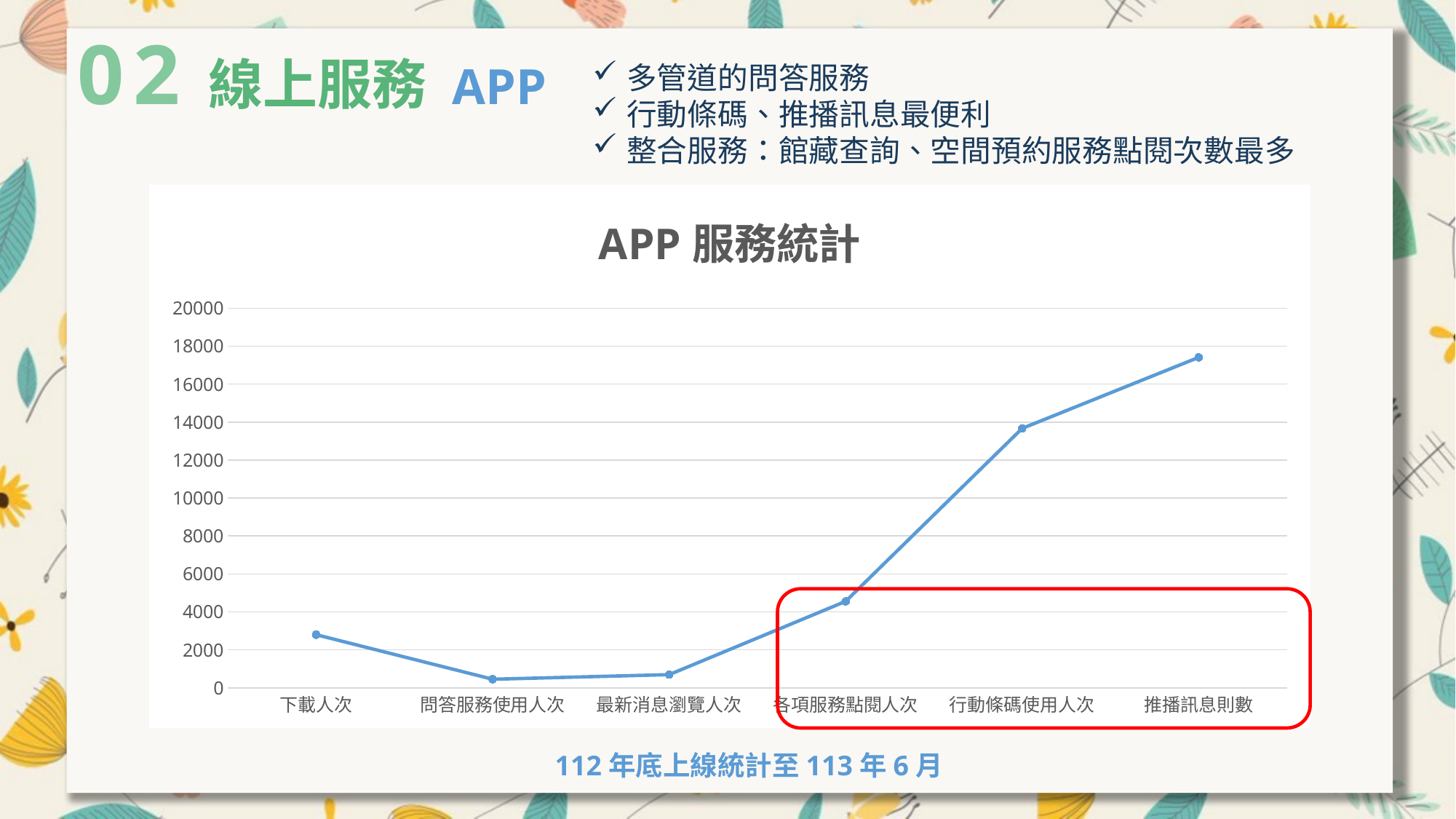
Which is larger, the value for 下載人次 or the value for 最新消息瀏覽人次? 下載人次 What is the title of the chart? APP 服務統計 Which category has the highest value in the chart? 推播訊息則數 How many categories are plotted along the x axis of the chart? 6 What type of chart is shown on the slide? line chart Is the value for 行動條碼使用人次 greater or less than 12000? greater Do the values rise or fall from 最新消息瀏覽人次 to 推播訊息則數 along the x axis? rise Which is larger, the value for 行動條碼使用人次 or the value for 各項服務點閱人次? 行動條碼使用人次 Which category has the lowest value in the chart? 問答服務使用人次 Is the value for 推播訊息則數 greater or less than 16000? greater Is the value for 下載人次 greater or less than 4000? less